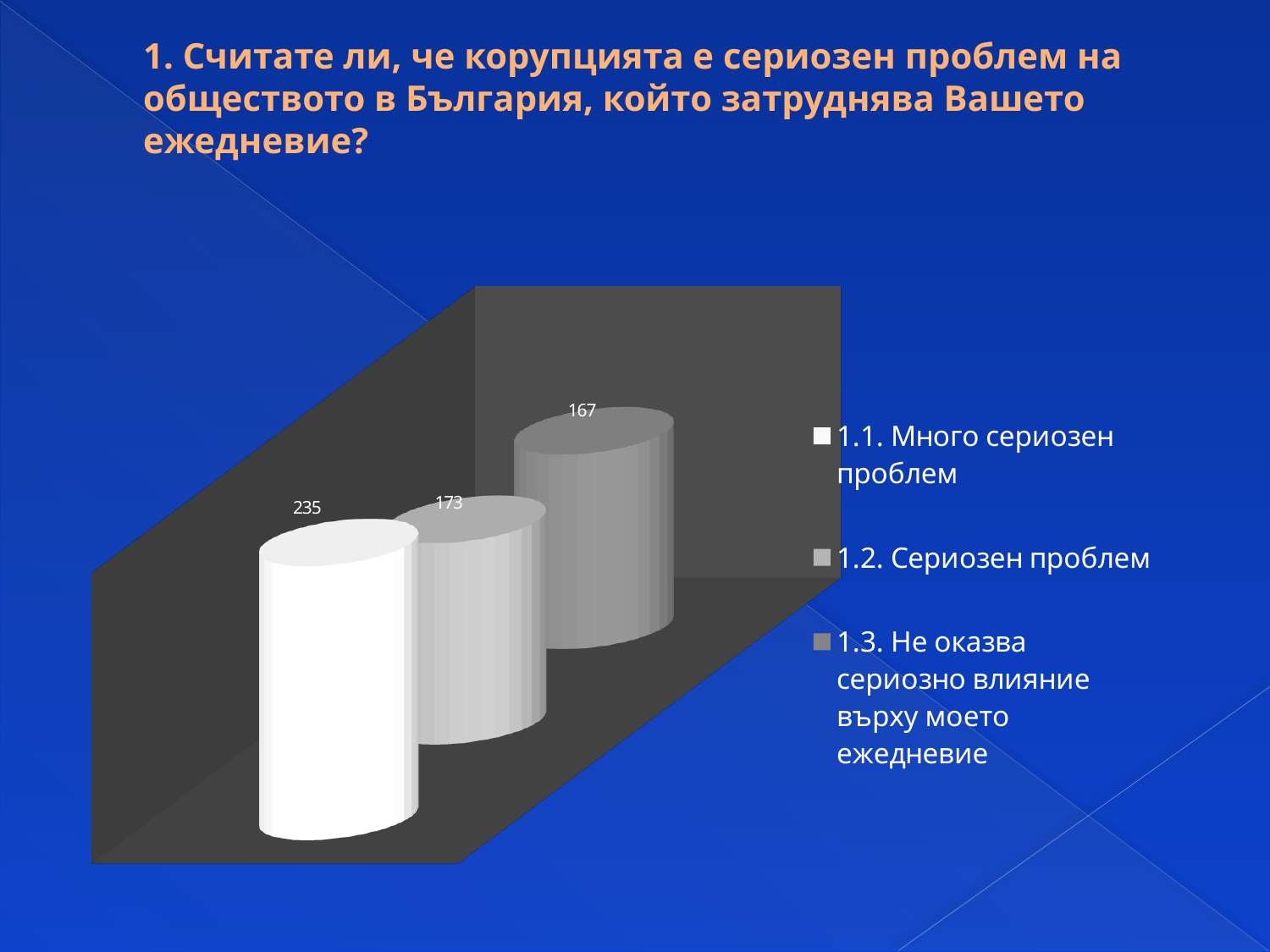
What is the total of the three plotted values? 575 Which is larger, the value for "1.1. Много сериозен проблем" or the value for "1.2. Сериозен проблем"? 1.1. Много сериозен проблем What is the value for "1.2. Сериозен проблем"? 173 Which category has the lowest value? 1.3. Не оказва сериозно влияние върху моето ежедневие What is the difference between the values for "1.1. Много сериозен проблем" and "1.3. Не оказва сериозно влияние върху моето ежедневие"? 68 What is the difference between the values for "1.2. Сериозен проблем" and "1.3. Не оказва сериозно влияние върху моето ежедневие"? 6 How many categories are plotted in the chart? 3 What kind of chart is shown on the slide? Bar chart How many entries does the legend list? 3 Which category has the highest value? 1.1. Много сериозен проблем What is the value for "1.1. Много сериозен проблем"? 235 What is the value for "1.3. Не оказва сериозно влияние върху моето ежедневие"? 167